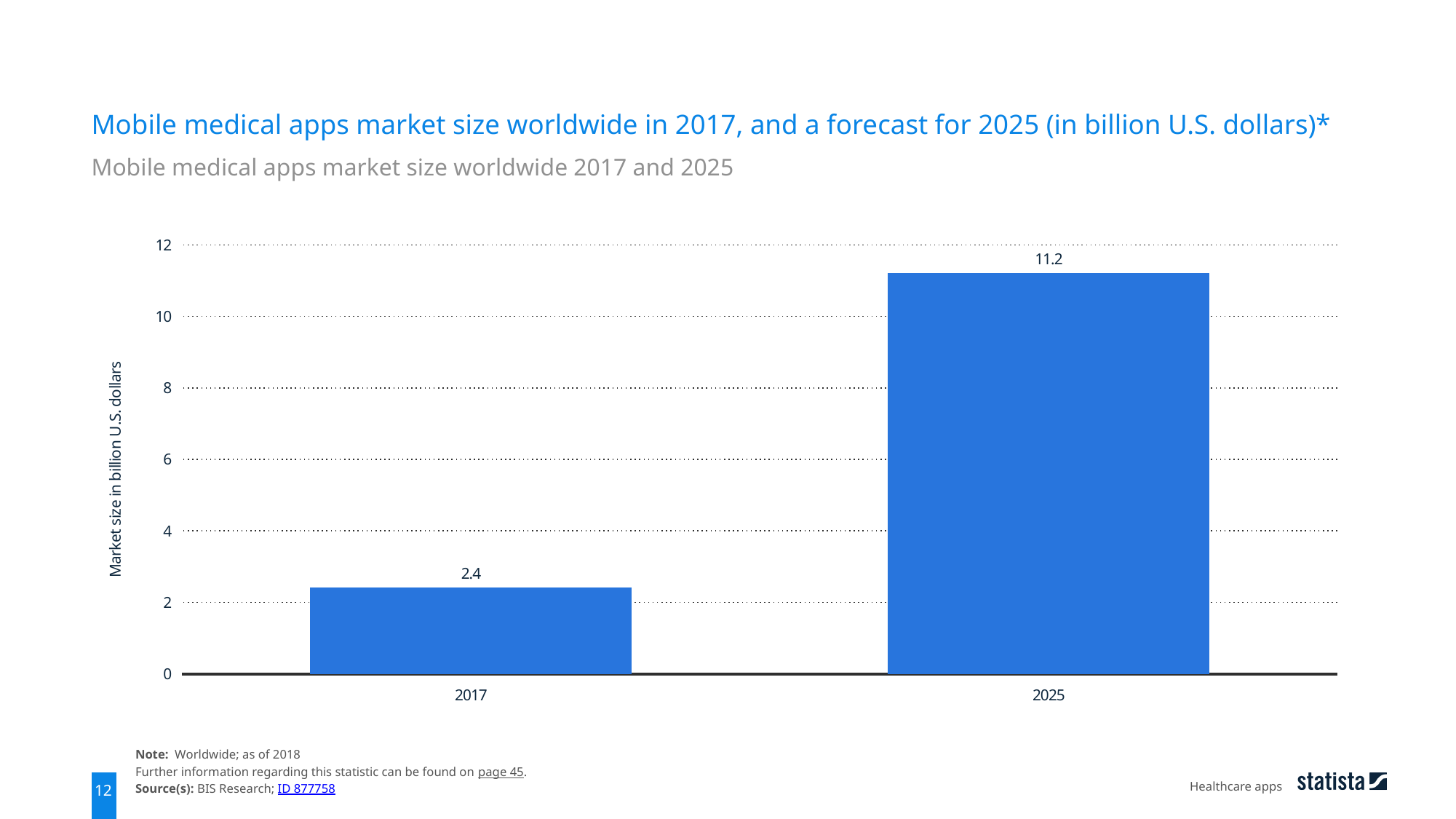
What kind of chart is shown on the slide? Bar chart Is the value for 2025 larger than the value for 2017? Yes What is the label of the y axis? Market size in billion U.S. dollars Does the market size rise or fall from 2017 to 2025? Rise How many years are shown on the x axis? 2 Which year has the lower market size value? 2017 What is the mobile medical apps market size for 2017? 2.4 Is the value for 2017 greater or less than 4? less Is the value for 2025 greater or less than 10? greater What is the forecast mobile medical apps market size for 2025? 11.2 Which year has the higher market size value? 2025 What is the difference between the 2025 and 2017 market size values? 8.8